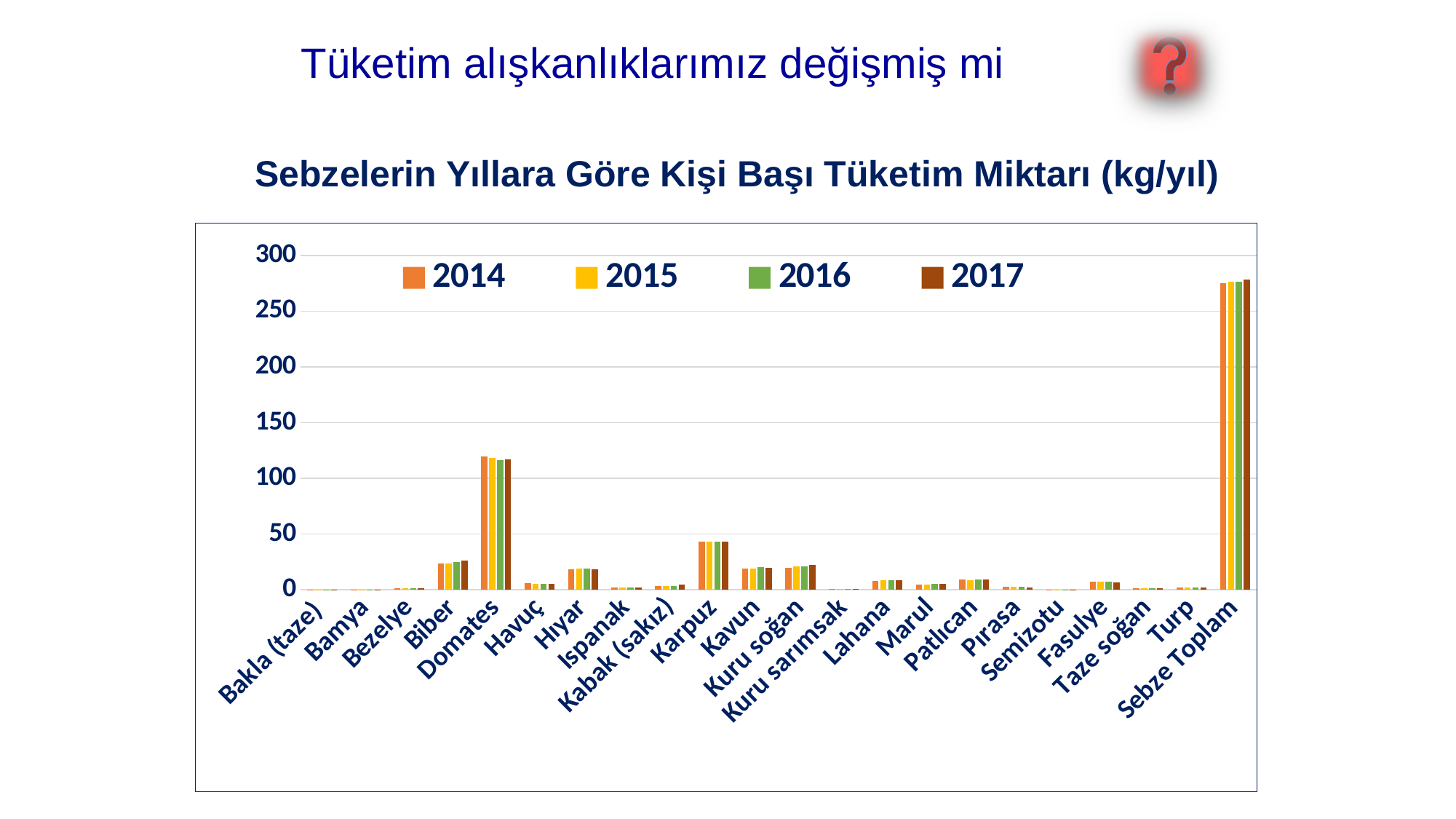
How many series does the legend list? 4 Which has the larger 2014 value, Domates or Karpuz? Domates How many categories are shown on the x axis of the chart? 22 Is the 2017 value for Sebze Toplam greater or less than 250? greater Is the 2015 value for Karpuz greater or less than 50? less Is the 2014 value for Domates greater or less than 100? greater Excluding Sebze Toplam, which vegetable has the highest per-capita consumption? Domates Which years are listed in the chart legend? 2014, 2015, 2016, 2017 Which category has the highest values in the chart? Sebze Toplam Which has the larger 2017 value, Karpuz or Kavun? Karpuz What kind of chart is shown on the slide? Bar chart